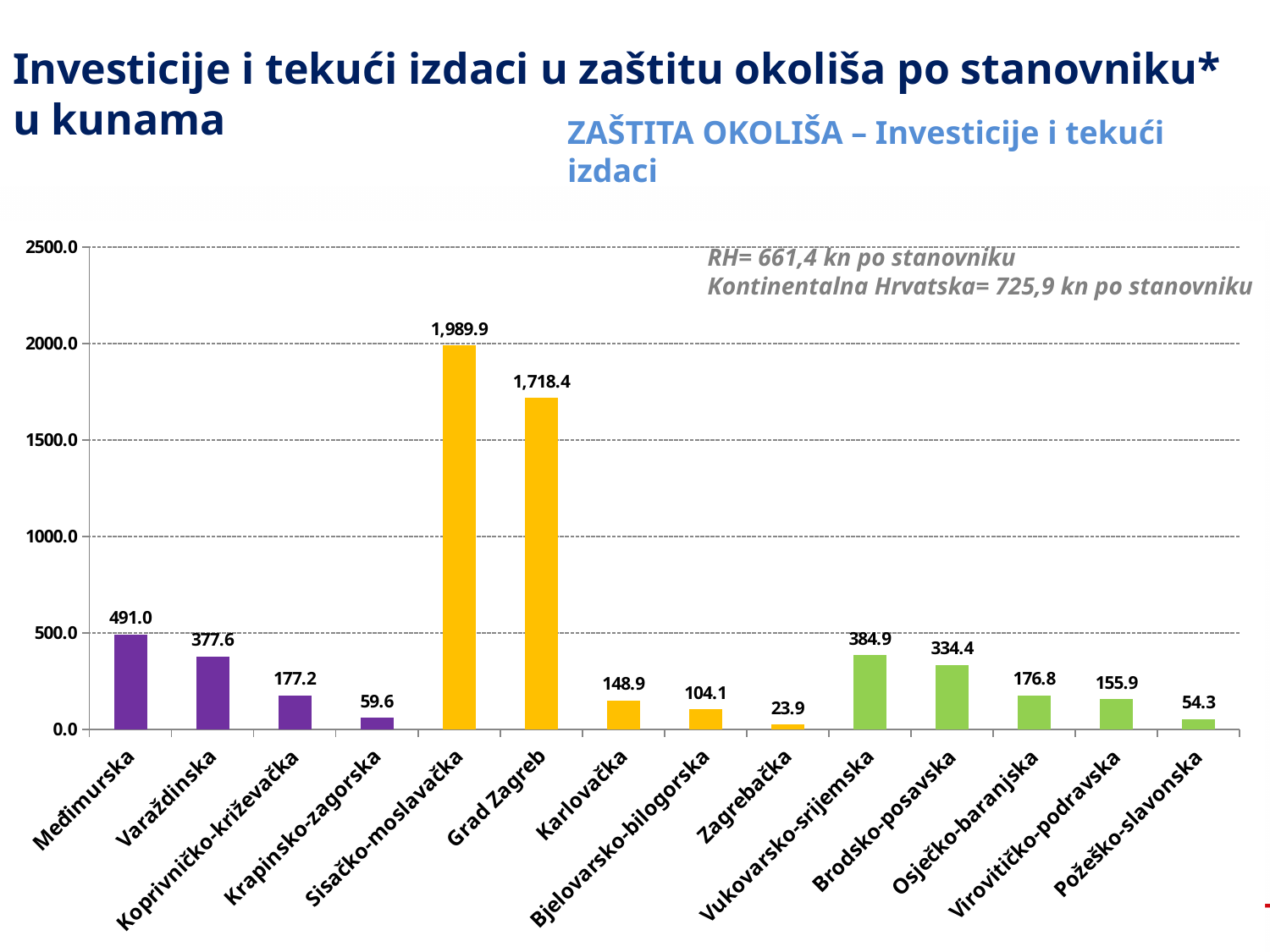
What is the value for Zagrebačka? 23.9 Which category has the highest value? Sisačko-moslavačka What is the value for Sisačko-moslavačka? 1,989.9 What is the difference between the values for Sisačko-moslavačka and Grad Zagreb? 271.5 Which category has the lowest value? Zagrebačka What is the value for Grad Zagreb? 1,718.4 What is the difference between the values for Međimurska and Varaždinska? 113.4 What is the value for Vukovarsko-srijemska? 384.9 Is the value for Grad Zagreb greater or less than 1500? greater How many categories are shown on the x axis? 14 What kind of chart is shown on the slide? bar chart Which is larger, the value for Vukovarsko-srijemska or Brodsko-posavska? Vukovarsko-srijemska